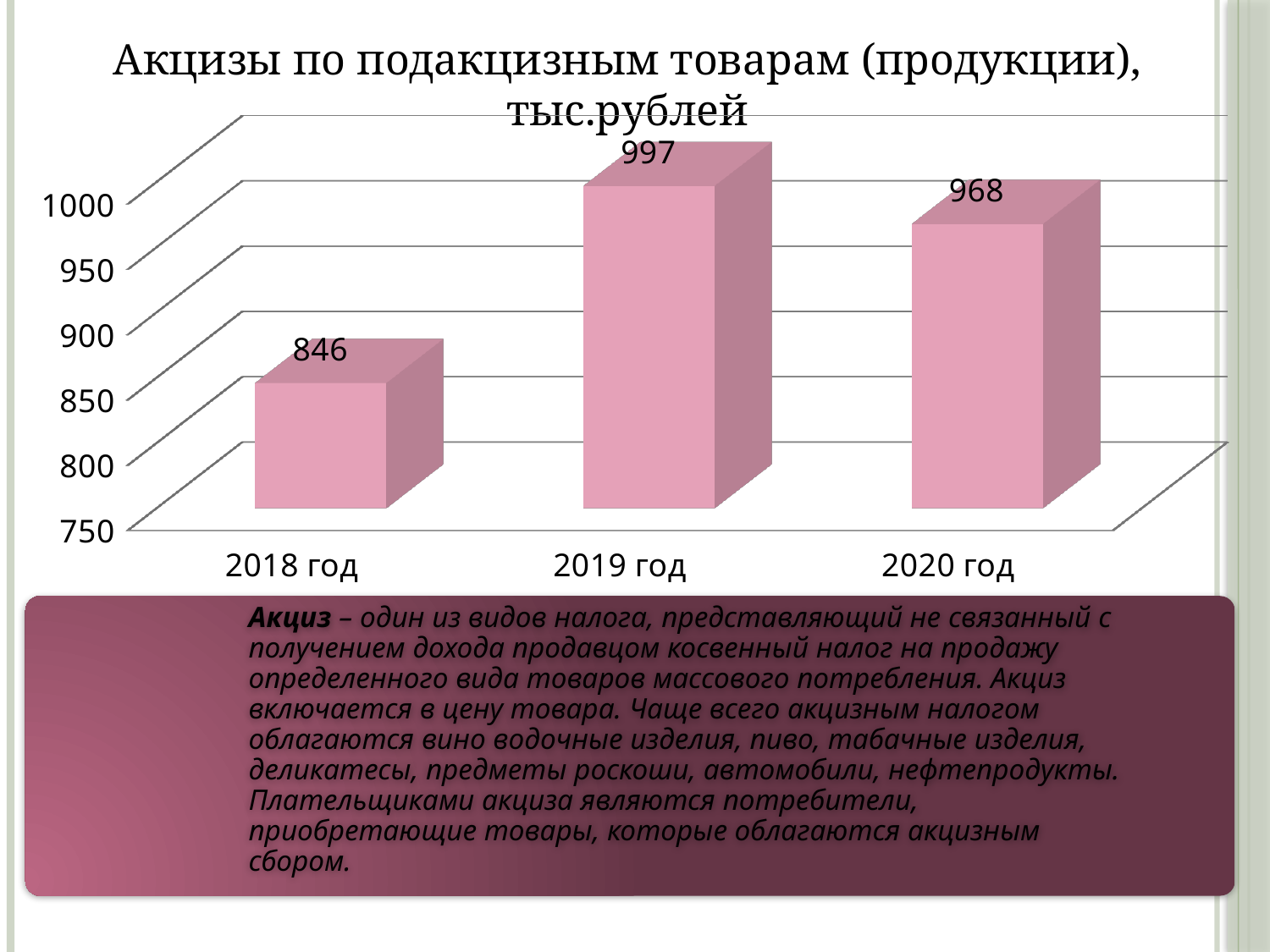
What is the difference between the values for 2019 год and 2018 год? 151 What is the value for 2020 год? 968 How many categories are shown on the x axis? 3 What kind of chart is shown on the slide? bar chart What is the value for 2019 год? 997 What is the title of the chart? Акцизы по подакцизным товарам (продукции), тыс.рублей What is the difference between the values for 2019 год and 2020 год? 29 Which year has the lowest value? 2018 год Which is larger, the value for 2020 год or the value for 2018 год? 2020 год What is the value for 2018 год? 846 Is the value for 2018 год greater or less than 900? less Which year has the highest value? 2019 год